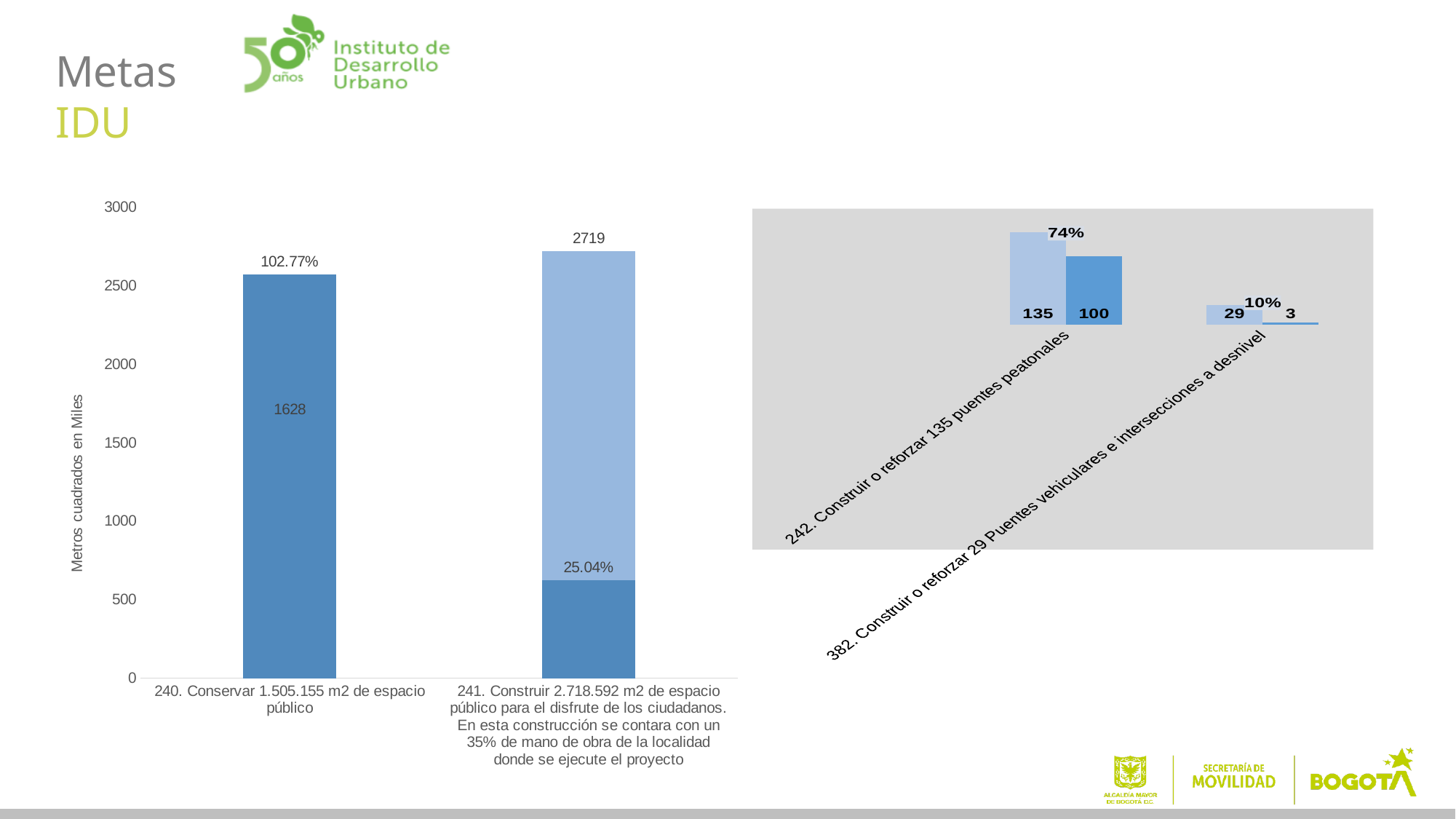
On the left chart, is the top of the bar for '241. Construir 2.718.592 m2 de espacio público' greater or less than 2500? greater On the left chart, what value label is shown at the top of the bar for '241. Construir 2.718.592 m2 de espacio público'? 2719 On the right chart, what are the two values labelled for '242. Construir o reforzar 135 puentes peatonales'? 135 and 100 On the left chart, how many categories are shown on the x axis? 2 What kind of chart is the left chart on the slide? bar chart On the right chart, what percentage label is shown for '382. Construir o reforzar 29 Puentes vehiculares e intersecciones a desnivel'? 10% On the right chart, what is the difference between the two values labelled for '382. Construir o reforzar 29 Puentes vehiculares e intersecciones a desnivel' (29 and 3)? 26 On the left chart, what is the y-axis title? Metros cuadrados en Miles On the left chart, what percentage label is shown on the bar for '241. Construir 2.718.592 m2 de espacio público'? 25.04% On the right chart, which category has the higher percentage label, '242. Construir o reforzar 135 puentes peatonales' or '382. Construir o reforzar 29 Puentes vehiculares e intersecciones a desnivel'? 242. Construir o reforzar 135 puentes peatonales On the left chart, what percentage label is shown above the bar for '240. Conservar 1.505.155 m2 de espacio público'? 102.77% On the left chart, what value label is printed inside the bar for '240. Conservar 1.505.155 m2 de espacio público'? 1628